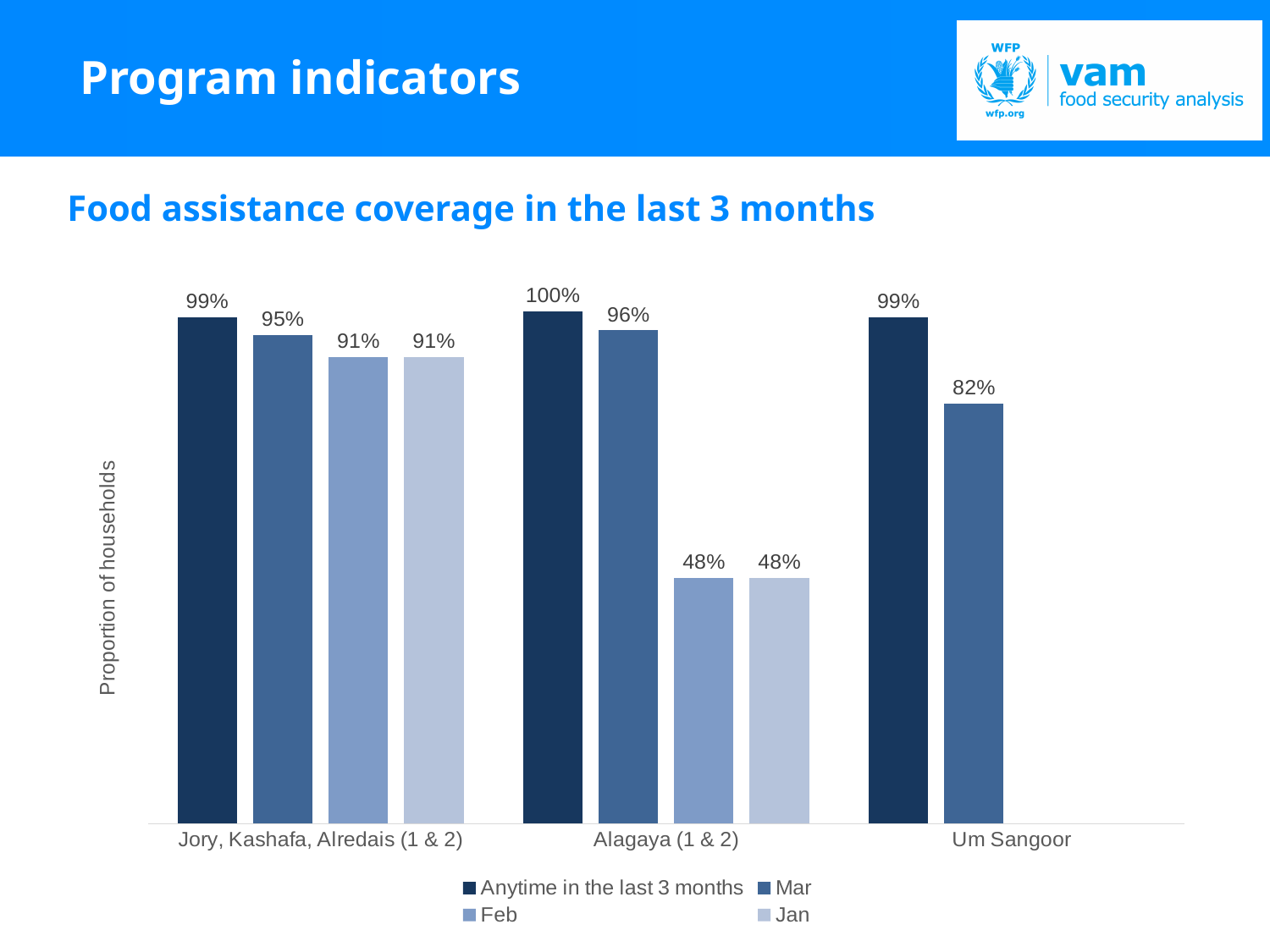
What is the value for 'Anytime in the last 3 months' in Jory, Kashafa, Alredais (1 & 2)? 99% What is the value for Feb in Alagaya (1 & 2)? 48% Which is larger: the Mar value in Jory, Kashafa, Alredais (1 & 2) or the Mar value in Alagaya (1 & 2)? Alagaya (1 & 2) How many categories are shown on the x axis? 3 Which category has the highest value for 'Anytime in the last 3 months'? Alagaya (1 & 2) What kind of chart is shown on the slide? Bar chart What is the difference between the Mar and Feb values in Alagaya (1 & 2)? 48% Which category has the lowest value for Mar? Um Sangoor What is the value for Mar in Um Sangoor? 82% How many series does the legend list? 4 What is the difference between the 'Anytime in the last 3 months' and Mar values in Um Sangoor? 17% What is the value for Jan in Jory, Kashafa, Alredais (1 & 2)? 91%